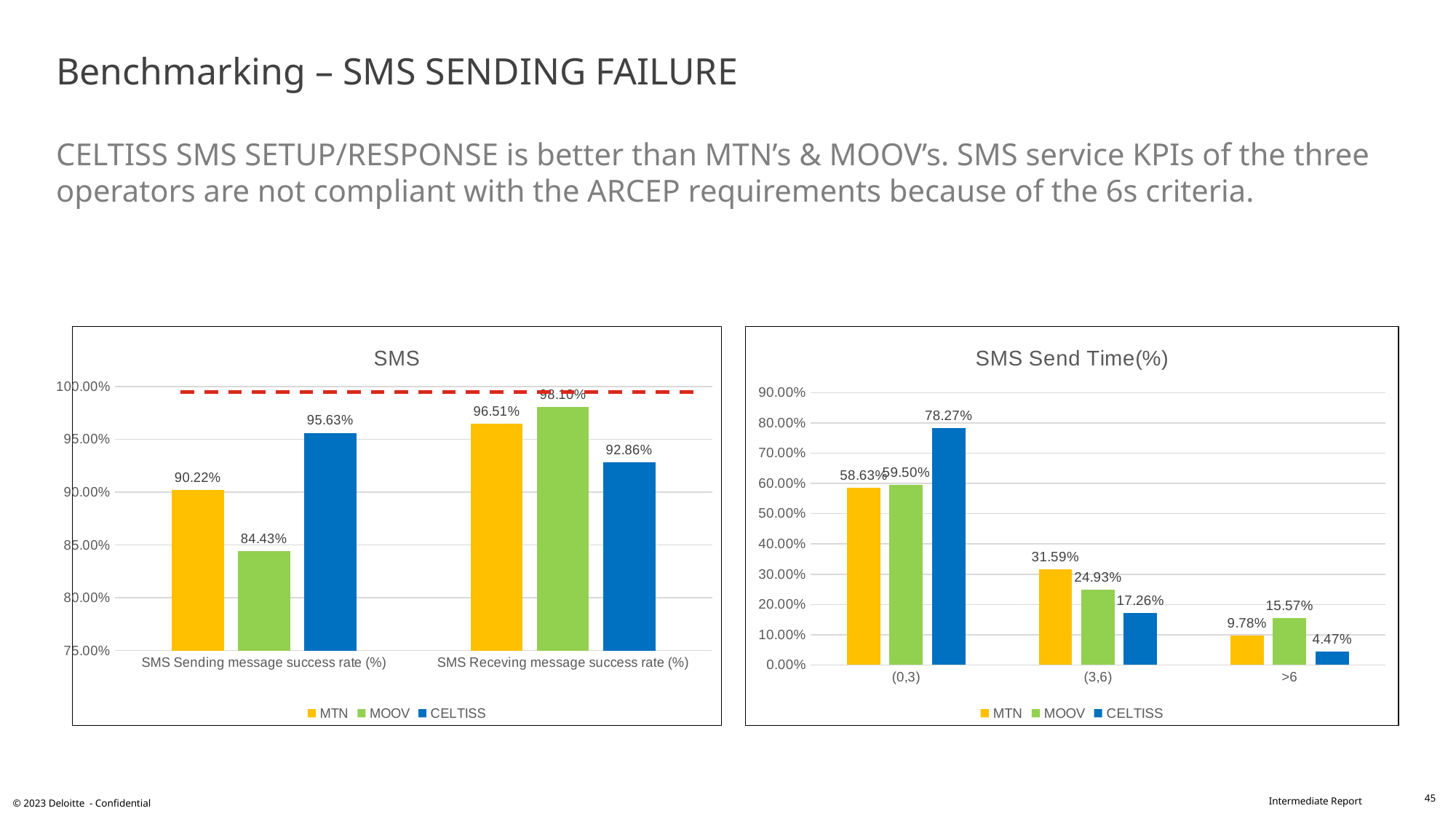
In the SMS chart, which operator has the lowest SMS Sending message success rate (%)? MOOV In the SMS chart, what is the difference between CELTISS's and MTN's SMS Sending message success rate (%)? 5.41% In the SMS chart, which is larger for SMS Receving message success rate (%): MTN or CELTISS? MTN In the SMS chart, what is the SMS Sending message success rate (%) for CELTISS? 95.63% In the SMS Send Time(%) chart, what is the value for CELTISS in the (0,3) category? 78.27% In the SMS Send Time(%) chart, what is the difference between MTN's and CELTISS's values in the (3,6) category? 14.33% How many series does the legend of the SMS chart list? 3 In the SMS chart, what is the SMS Sending message success rate (%) for MOOV? 84.43% How many categories are shown on the x axis of the SMS Send Time(%) chart? 3 What type of chart is the SMS Send Time(%) chart? Bar chart In the SMS Send Time(%) chart, what is the value for MOOV in the >6 category? 15.57% In the SMS Send Time(%) chart, which operator has the highest value in the (3,6) category? MTN